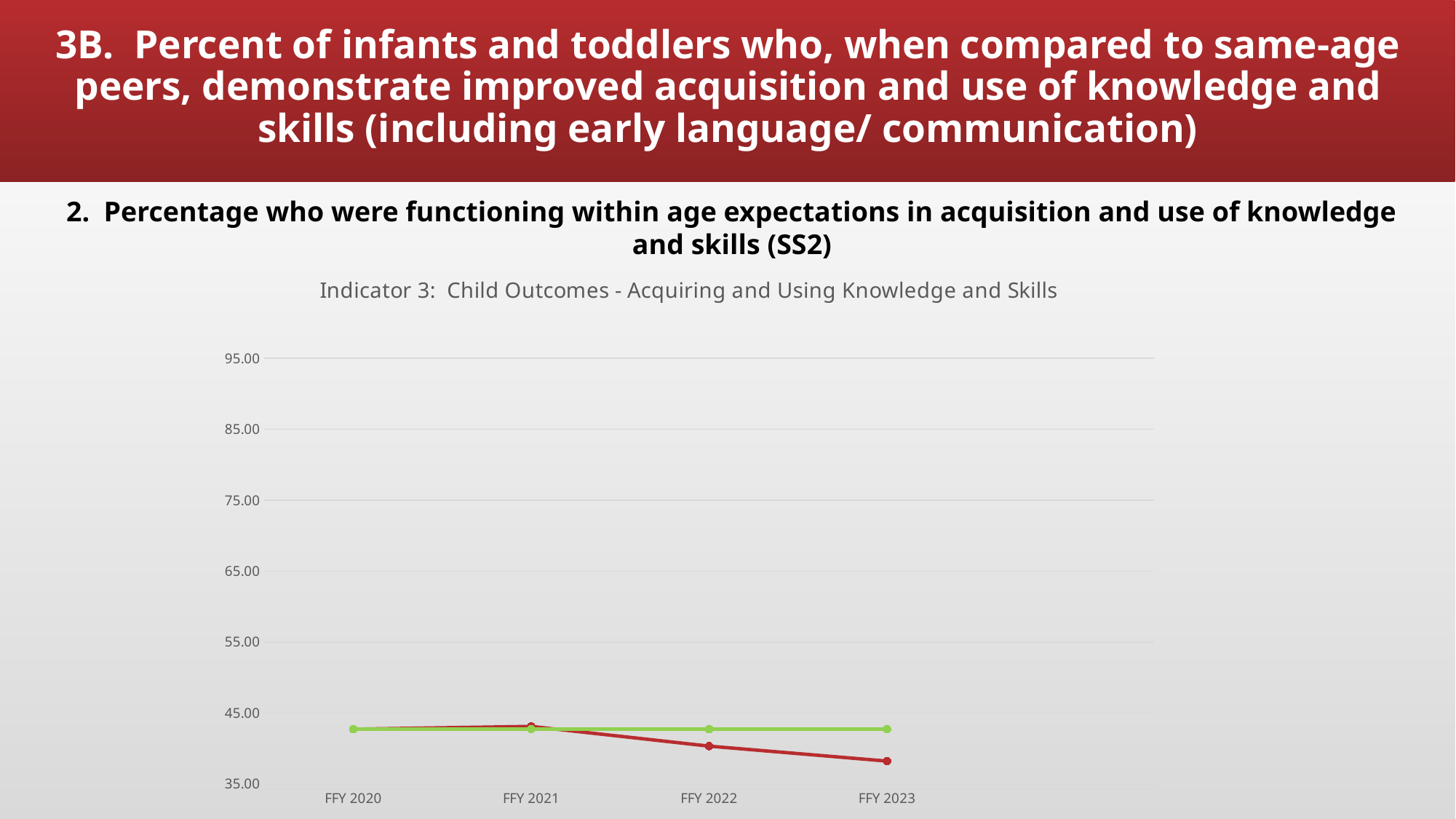
What is the title of the chart? Indicator 3: Child Outcomes - Acquiring and Using Knowledge and Skills In which fiscal year does the red line reach its lowest value? FFY 2023 Is the value of the green line at FFY 2020 greater or less than 55.00? less What kind of chart is shown on the slide? line chart Does the red line rise or fall from FFY 2021 to FFY 2023? fall Is the value of the green line at FFY 2023 greater or less than 35.00? greater How many lines are plotted on the chart? 2 At FFY 2023, which line has the higher value, the green line or the red line? green line Is the value of the red line at FFY 2023 greater or less than 45.00? less At FFY 2022, which line has the higher value, the green line or the red line? green line How many fiscal years are shown on the x axis of the chart? 4